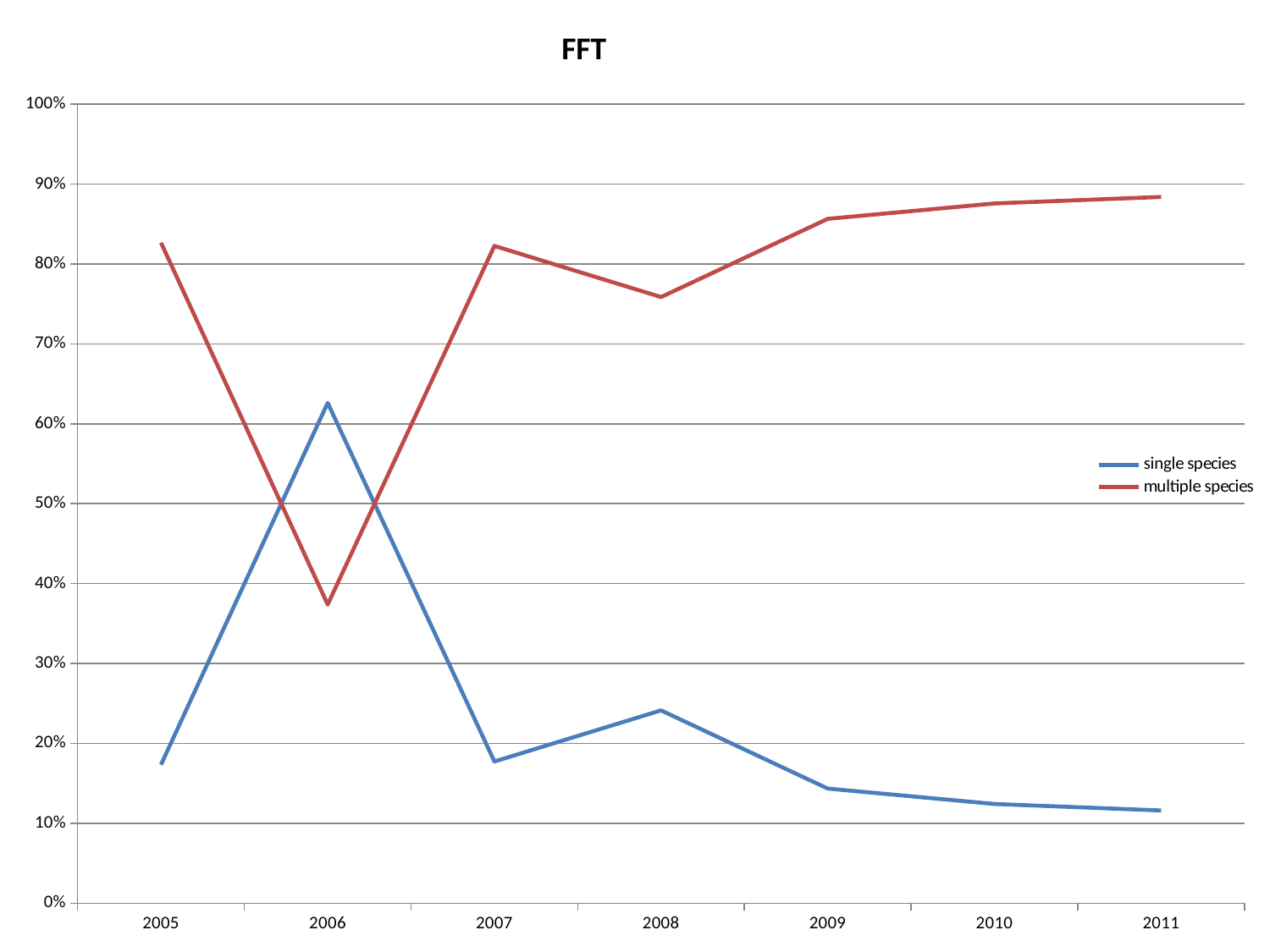
Which series has the larger value in 2005, single species or multiple species? multiple species In which year is the multiple species series lowest? 2006 What kind of chart is shown on the slide? line chart Is the value for single species in 2011 greater or less than 20%? less Is the value for single species in 2006 greater or less than 60%? greater Is the value for multiple species in 2008 greater or less than 70%? greater From 2008 to 2011, does the single species series rise or fall? fall What is the title of the chart? FFT In which year is the single species series highest? 2006 How many years are shown on the x axis? 7 How many series does the legend list? 2 In which year is the multiple species series highest? 2011